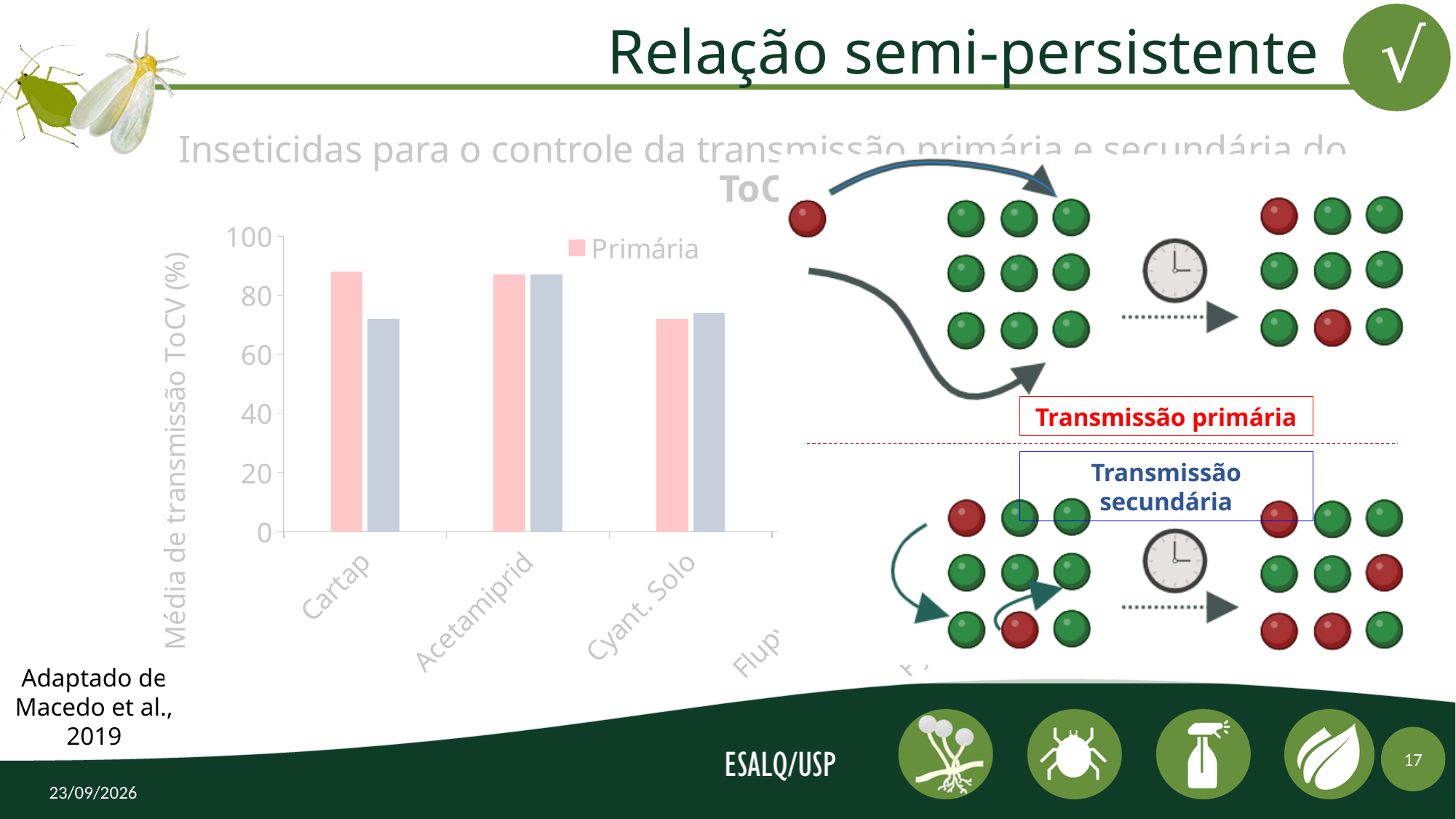
Is the value of the grey bar for Acetamiprid greater or less than 80? greater For Cartap, which bar is taller, the pink Primária bar or the grey bar? the pink Primária bar Is the Primária value for Cyant. Solo greater or less than 80? less What kind of chart is shown on the left of the slide? bar chart Is the value of the grey bar for Cartap greater or less than 80? less What is the title of the vertical axis of the bar chart? Média de transmissão ToCV (%) Which series name is readable in the legend of the bar chart? Primária Which has the larger Primária value, Cartap or Cyant. Solo? Cartap Among Cartap, Acetamiprid and Cyant. Solo, which has the lowest Primária value? Cyant. Solo